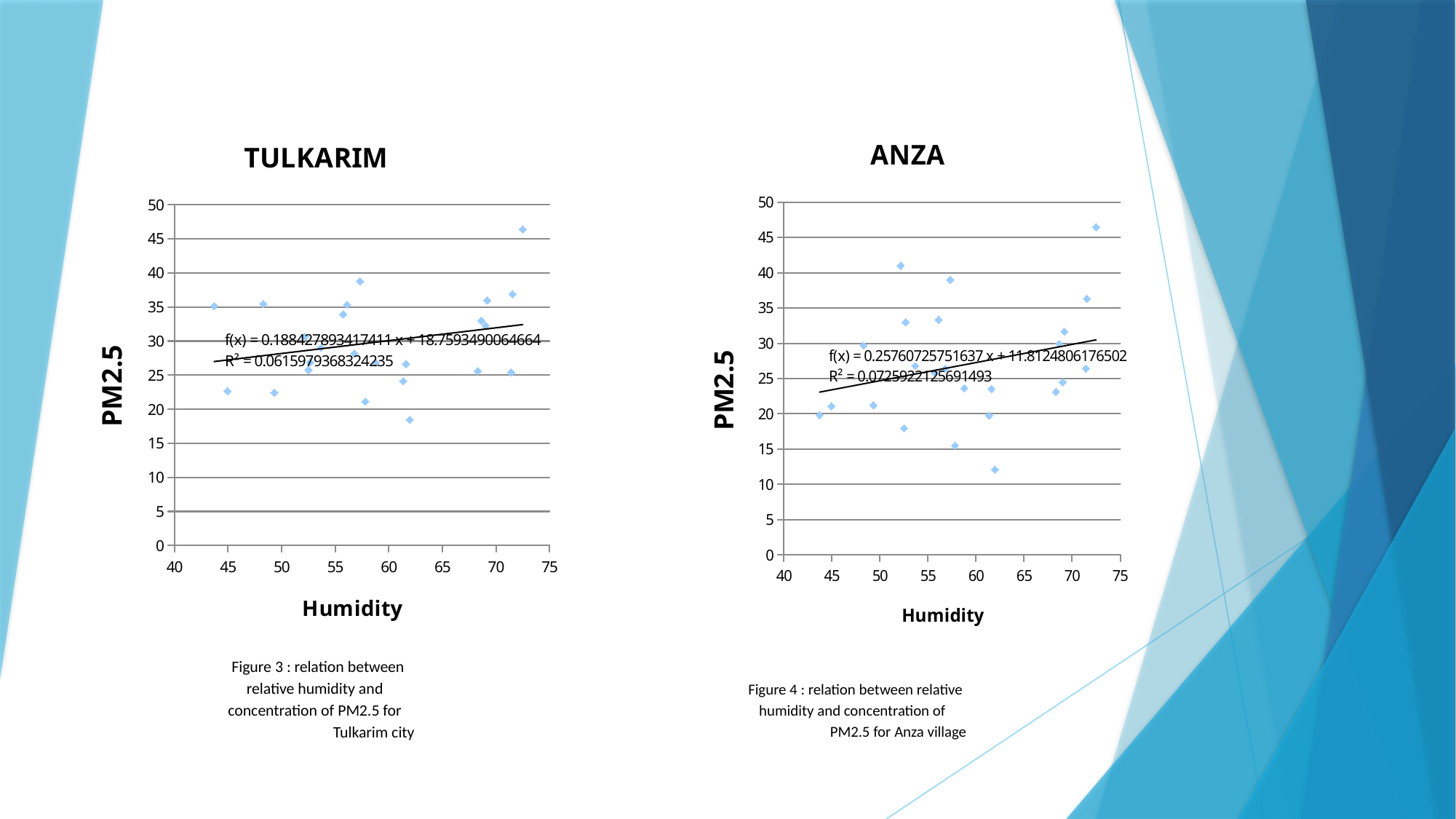
In the ANZA chart, does the trendline rise or fall as humidity increases? rise In the TULKARIM chart, does the trendline rise or fall as humidity increases? rise In the ANZA chart, is the lowest PM2.5 point greater or less than 15? less In the ANZA chart, what is the R² value shown for the trendline? 0.0725922125691493 In the TULKARIM chart, what is the R² value shown for the trendline? 0.0615979368324235 What kind of chart is the TULKARIM chart? scatter chart What is the label of the x axis on the TULKARIM chart? Humidity Which chart has the larger R² value, TULKARIM or ANZA? ANZA In the TULKARIM chart, what is the trendline equation shown? f(x) = 0.188427893417411 x + 18.7593490064664 In the ANZA chart, what is the trendline equation shown? f(x) = 0.25760725751637 x + 11.8124806176502 In the TULKARIM chart, is the highest PM2.5 point greater or less than 45? greater What kind of chart is the ANZA chart? scatter chart